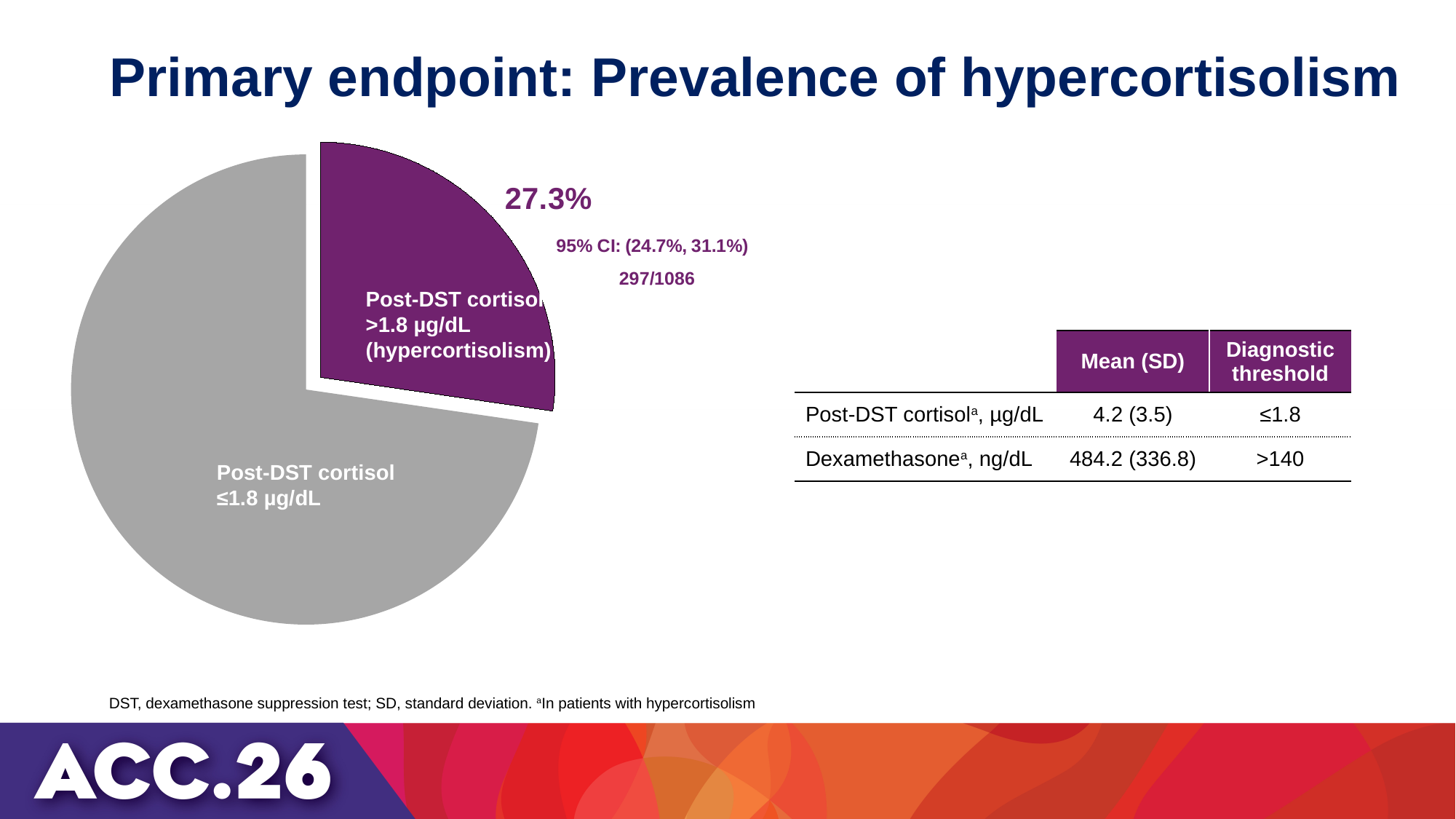
What fraction of patients is shown next to the hypercortisolism slice? 297/1086 What percentage of the pie does the Post-DST cortisol >1.8 µg/dL (hypercortisolism) slice represent? 27.3% What is the title of the slide containing the pie chart? Primary endpoint: Prevalence of hypercortisolism What share of the pie does the Post-DST cortisol ≤1.8 µg/dL slice represent? 72.7% Which slice of the pie chart is the smallest? Post-DST cortisol >1.8 µg/dL (hypercortisolism) Which slice of the pie chart is the largest? Post-DST cortisol ≤1.8 µg/dL What kind of chart is shown on the slide? pie chart How many slices does the pie chart have? 2 Which is larger in the pie chart: the Post-DST cortisol ≤1.8 µg/dL slice or the Post-DST cortisol >1.8 µg/dL slice? Post-DST cortisol ≤1.8 µg/dL What is the 95% confidence interval shown for the hypercortisolism slice? (24.7%, 31.1%) Is the share of the hypercortisolism slice greater or less than 50%? less What colour is the hypercortisolism slice in the pie chart? purple